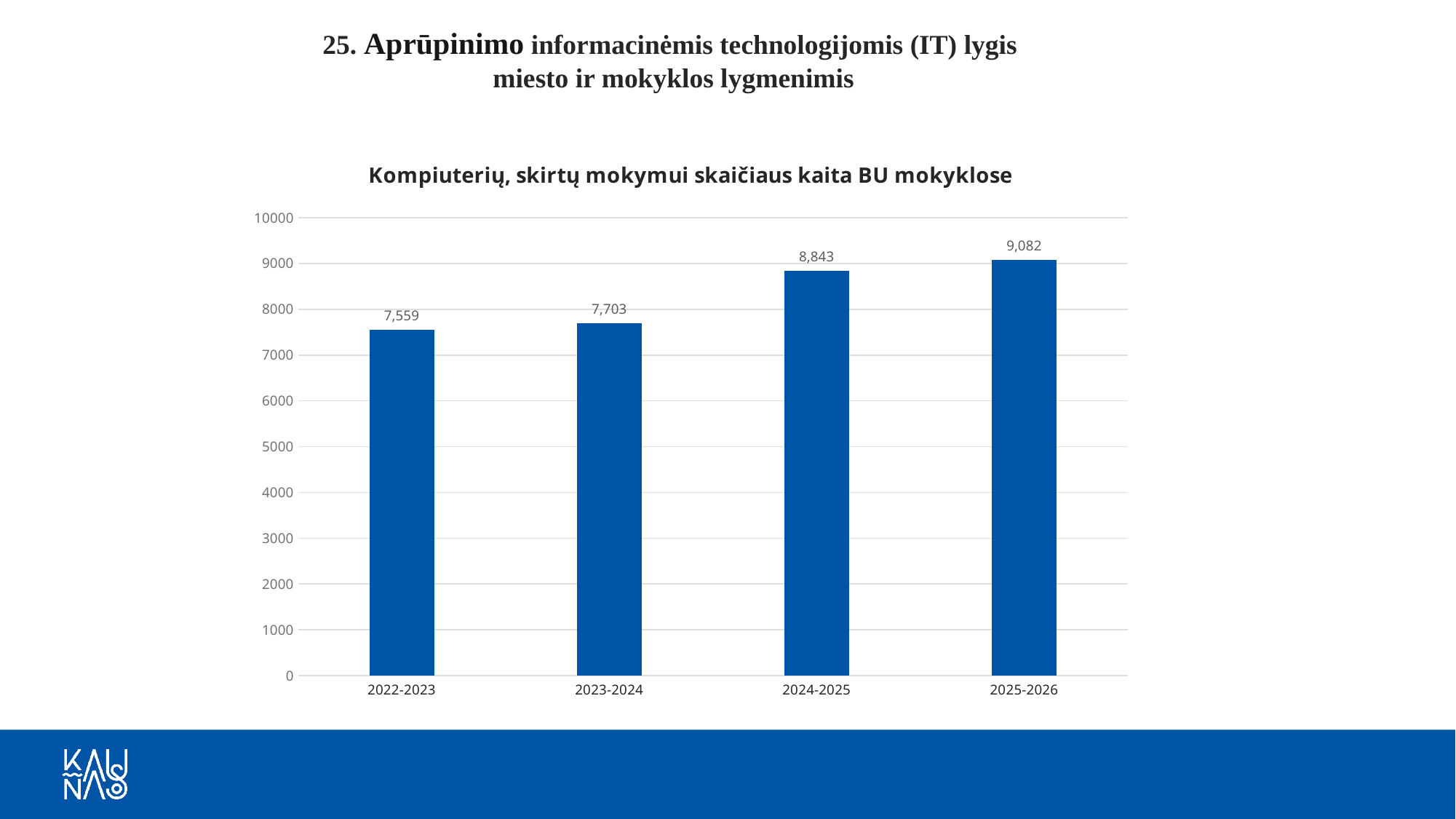
Is the value for 2023-2024 greater or less than 8000? less Which school year has the highest value? 2025-2026 What is the difference between the values for 2025-2026 and 2022-2023? 1,523 What is the value for 2022-2023? 7,559 Which is larger, the value for 2023-2024 or the value for 2024-2025? 2024-2025 Do the values rise or fall from 2022-2023 to 2025-2026? rise What kind of chart is shown on the slide? bar chart What is the value for 2025-2026? 9,082 Which school year has the lowest value? 2022-2023 What is the value for 2024-2025? 8,843 How many school years are shown on the x axis? 4 What is the difference between the values for 2024-2025 and 2023-2024? 1,140